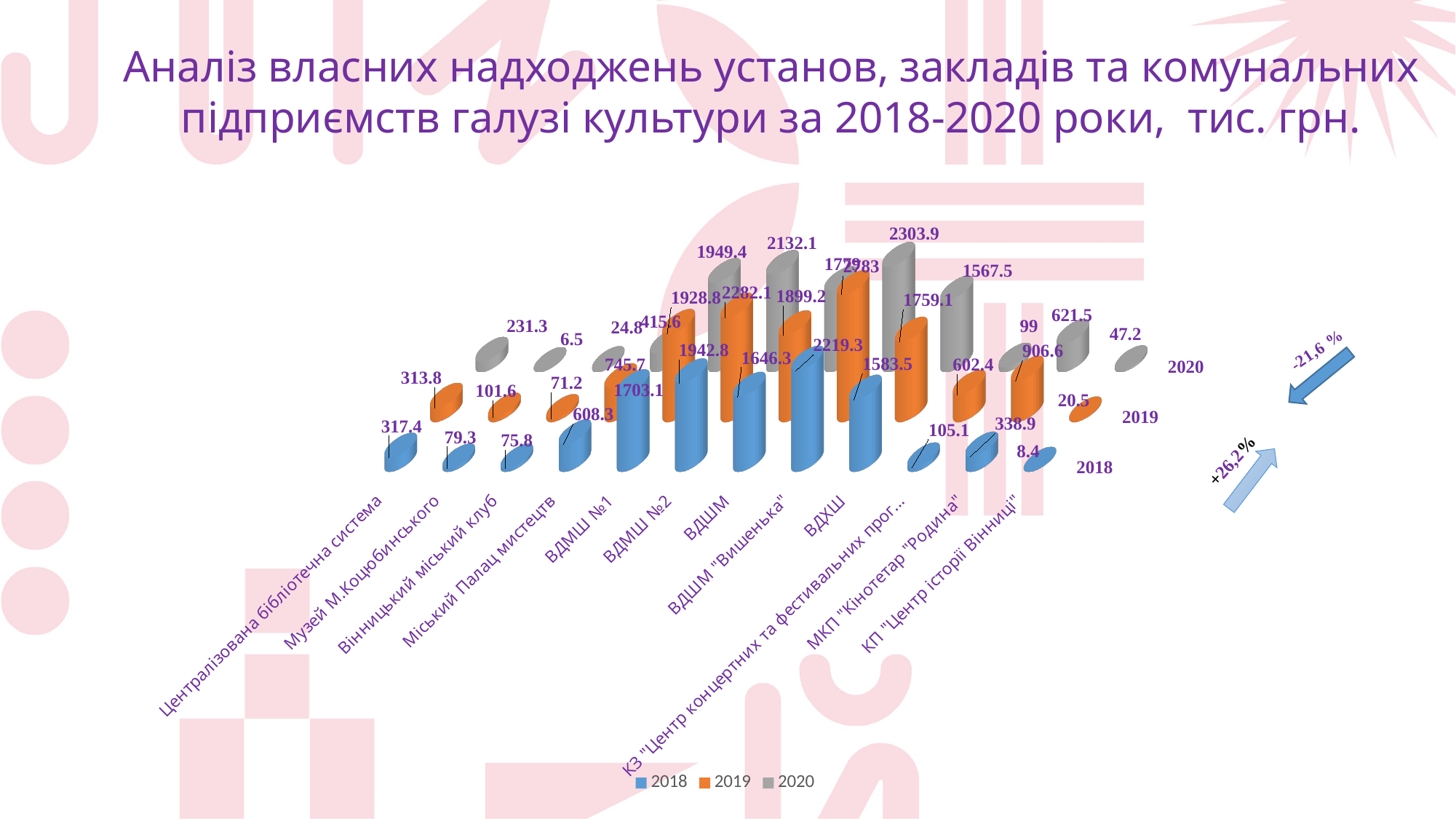
Which category has the highest 2018 value? ВДШМ "Вишенька" What kind of chart is shown on the slide? Bar chart How many categories are shown on the x axis? 12 What is the 2019 value for МКП "Кінотеатр "Родина"? 906.6 What is the 2019 value for ВДМШ №2? 2282.1 What is the 2020 value for Музей М.Коцюбинського? 6.5 Which category has the highest 2019 value? ВДШМ "Вишенька" What is the 2018 value for Централізована бібліотечна система? 317.4 For ВДМШ №1, which year has the larger value, 2018 or 2019? 2019 Which category has the lowest 2018 value? КП "Центр історії Вінниці" What is the difference between the 2019 and 2018 values for Міський Палац мистецтв? 137.4 How many series does the legend list? 3